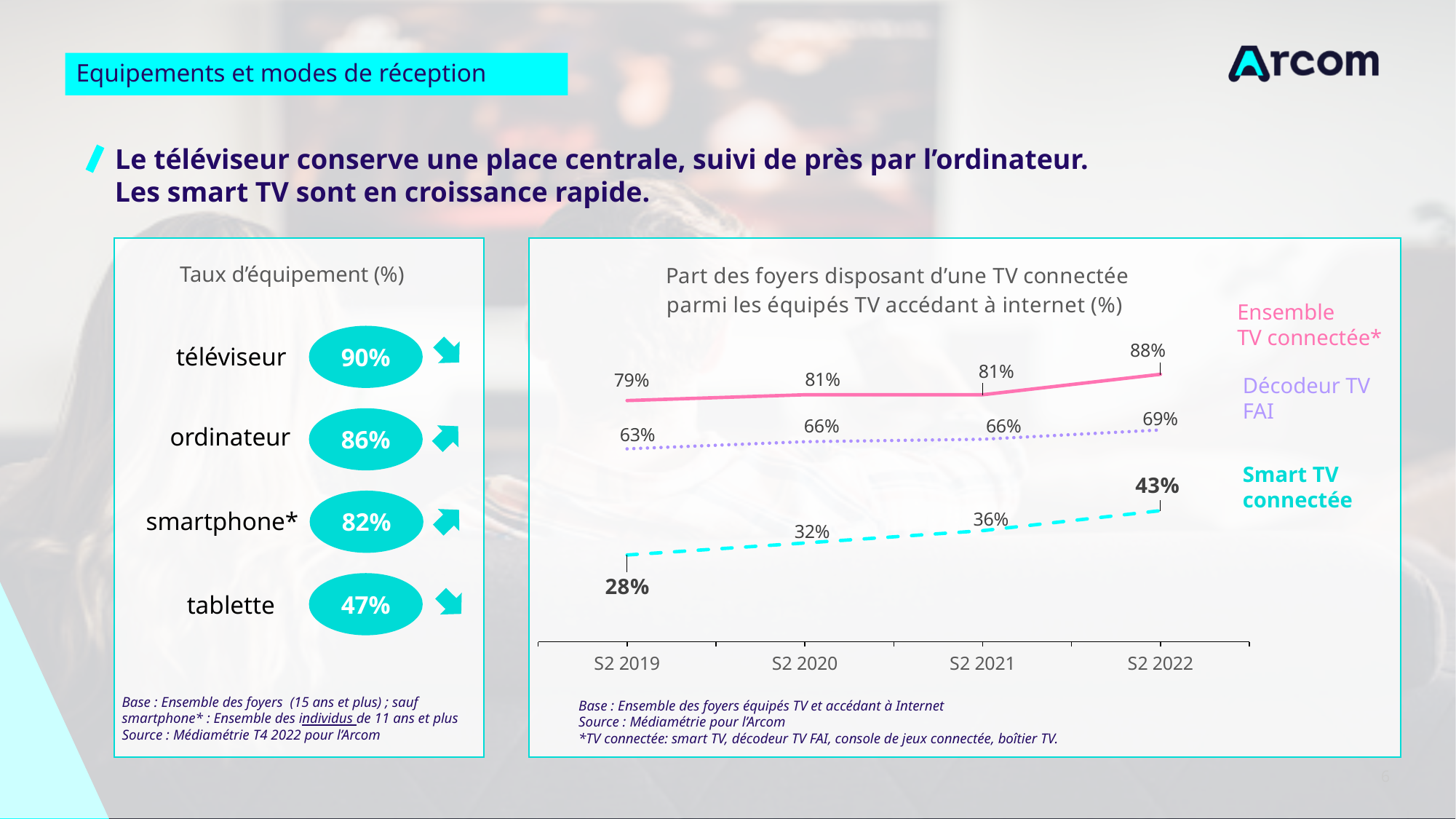
In the chart 'Part des foyers disposant d'une TV connectée parmi les équipés TV accédant à internet (%)', what is the value for Décodeur TV FAI in S2 2021? 66% In the chart 'Part des foyers disposant d'une TV connectée parmi les équipés TV accédant à internet (%)', what is the value for Smart TV connectée in S2 2022? 43% In the chart 'Part des foyers disposant d'une TV connectée parmi les équipés TV accédant à internet (%)', what is the value for Ensemble TV connectée* in S2 2019? 79% In the chart 'Part des foyers disposant d'une TV connectée parmi les équipés TV accédant à internet (%)', which series has the lowest value in S2 2019? Smart TV connectée In the chart 'Part des foyers disposant d'une TV connectée parmi les équipés TV accédant à internet (%)', by how many percentage points did Smart TV connectée increase from S2 2019 to S2 2022? 15 In the chart 'Part des foyers disposant d'une TV connectée parmi les équipés TV accédant à internet (%)', does the Smart TV connectée series rise or fall from S2 2019 to S2 2022? Rise What kind of chart is 'Part des foyers disposant d'une TV connectée parmi les équipés TV accédant à internet (%)'? Line chart In the chart 'Part des foyers disposant d'une TV connectée parmi les équipés TV accédant à internet (%)', what is the difference between Ensemble TV connectée* and Décodeur TV FAI in S2 2022? 19 In the chart 'Part des foyers disposant d'une TV connectée parmi les équipés TV accédant à internet (%)', which is larger in S2 2020: Décodeur TV FAI or Smart TV connectée? Décodeur TV FAI In the chart 'Part des foyers disposant d'une TV connectée parmi les équipés TV accédant à internet (%)', which series has the highest value in S2 2022? Ensemble TV connectée* In the chart 'Part des foyers disposant d'une TV connectée parmi les équipés TV accédant à internet (%)', how many series are shown? 3 In the chart 'Part des foyers disposant d'une TV connectée parmi les équipés TV accédant à internet (%)', how many time points are shown on the x axis? 4